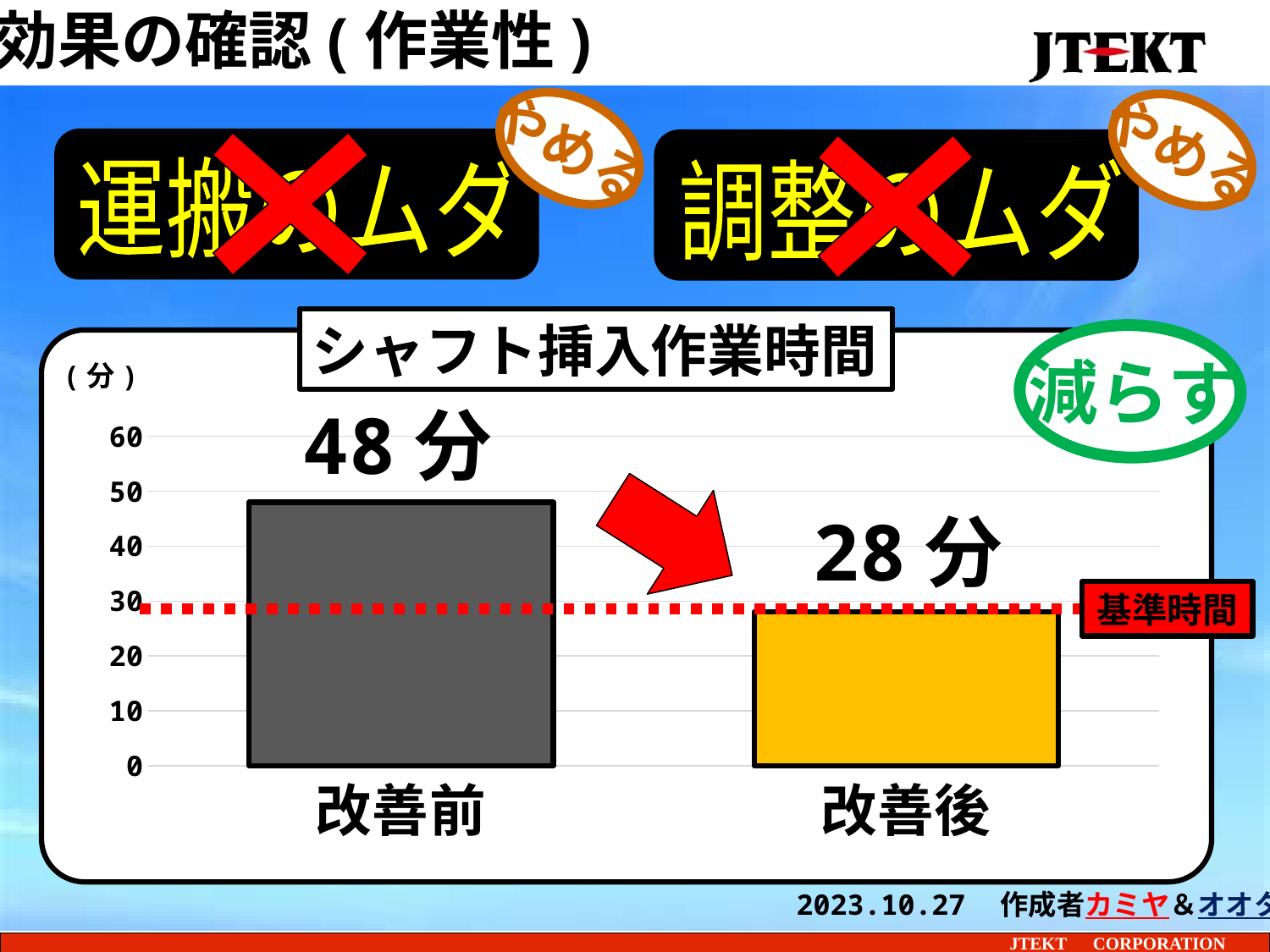
Which category has the highest value in the シャフト挿入作業時間 chart? 改善前 What is the difference between the 改善前 and 改善後 values in the シャフト挿入作業時間 chart? 20分 Is the value for 改善前 in the シャフト挿入作業時間 chart greater or less than 40? greater What is the title of the chart on the slide? シャフト挿入作業時間 What is the label of the red dashed horizontal line in the シャフト挿入作業時間 chart? 基準時間 Which is larger in the シャフト挿入作業時間 chart, 改善前 or 改善後? 改善前 Which category has the lowest value in the シャフト挿入作業時間 chart? 改善後 What is the value for 改善前 in the シャフト挿入作業時間 chart? 48分 How many categories are shown in the シャフト挿入作業時間 chart? 2 Is the value for 改善後 in the シャフト挿入作業時間 chart greater or less than 30? less What is the value for 改善後 in the シャフト挿入作業時間 chart? 28分 What kind of chart is the シャフト挿入作業時間 chart? bar chart